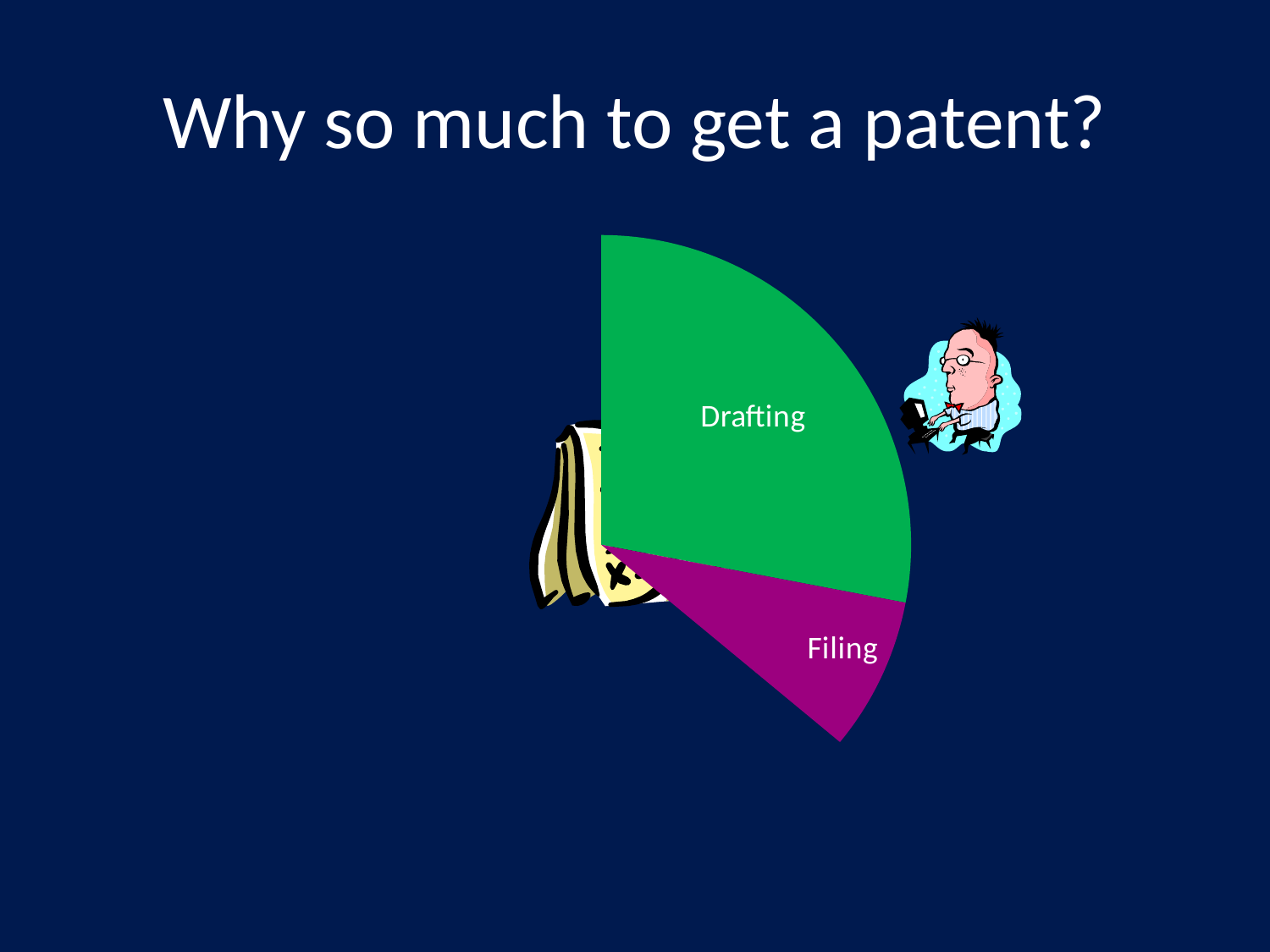
Which labelled slice of the pie chart is the smallest? Filing Which labelled slice of the pie chart is the largest? Drafting What colour is the Drafting slice? green What colour is the Filing slice? magenta Which slice is larger, Drafting or Filing? Drafting How many labelled slices are visible in the pie chart? 2 What kind of chart is shown on the slide? pie chart